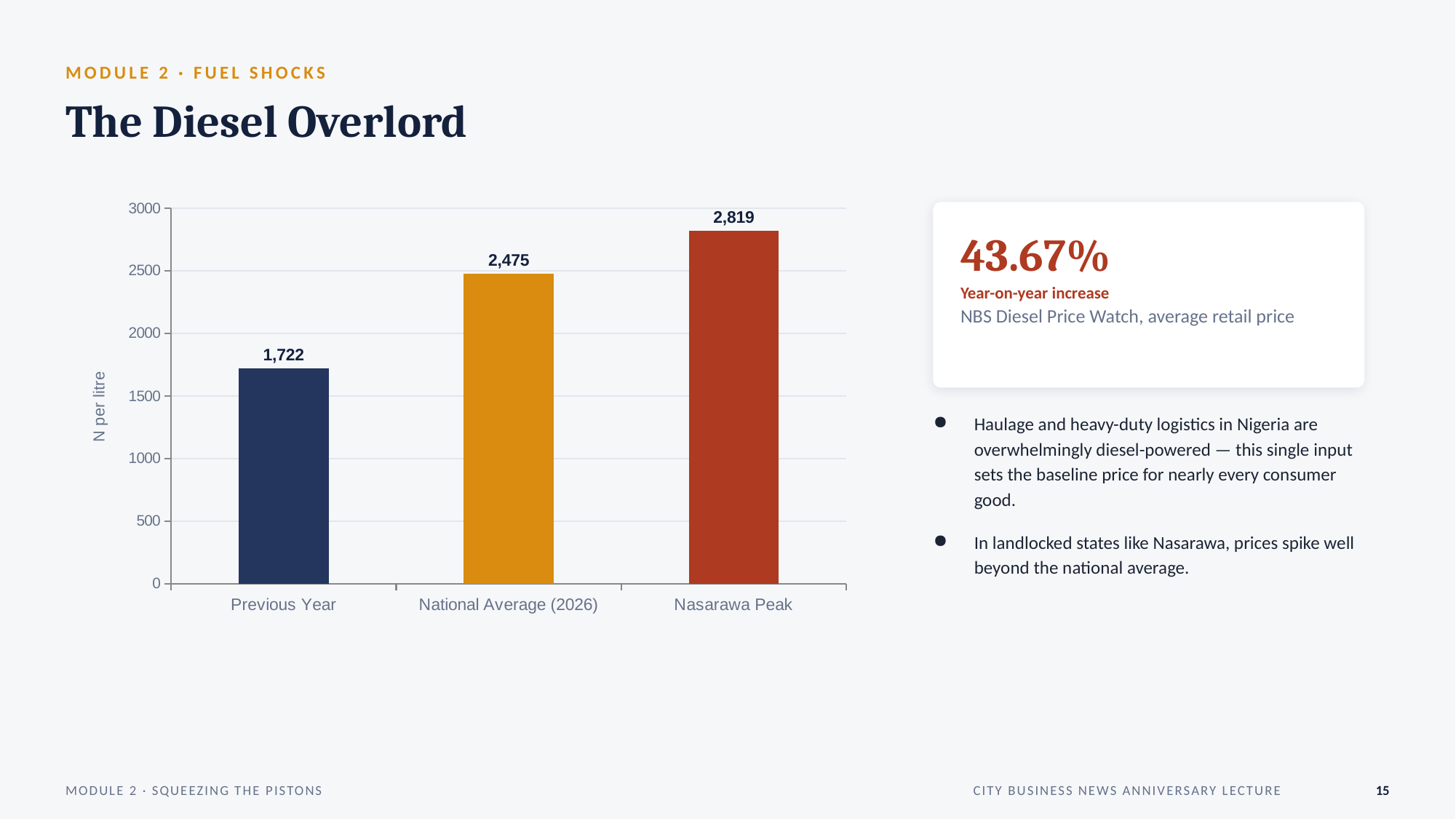
What kind of chart is shown on the slide? bar chart How many categories are shown in the chart? 3 Which is larger, Previous Year or National Average (2026)? National Average (2026) What is the difference between Nasarawa Peak and National Average (2026)? 344 Which category has the highest value? Nasarawa Peak What is the difference between National Average (2026) and Previous Year? 753 What is the value for Nasarawa Peak? 2,819 Is the value for Previous Year greater or less than 2000? less What is the value for National Average (2026)? 2,475 What is the value for Previous Year? 1,722 What is the label on the vertical axis of the chart? N per litre Which category has the lowest value? Previous Year